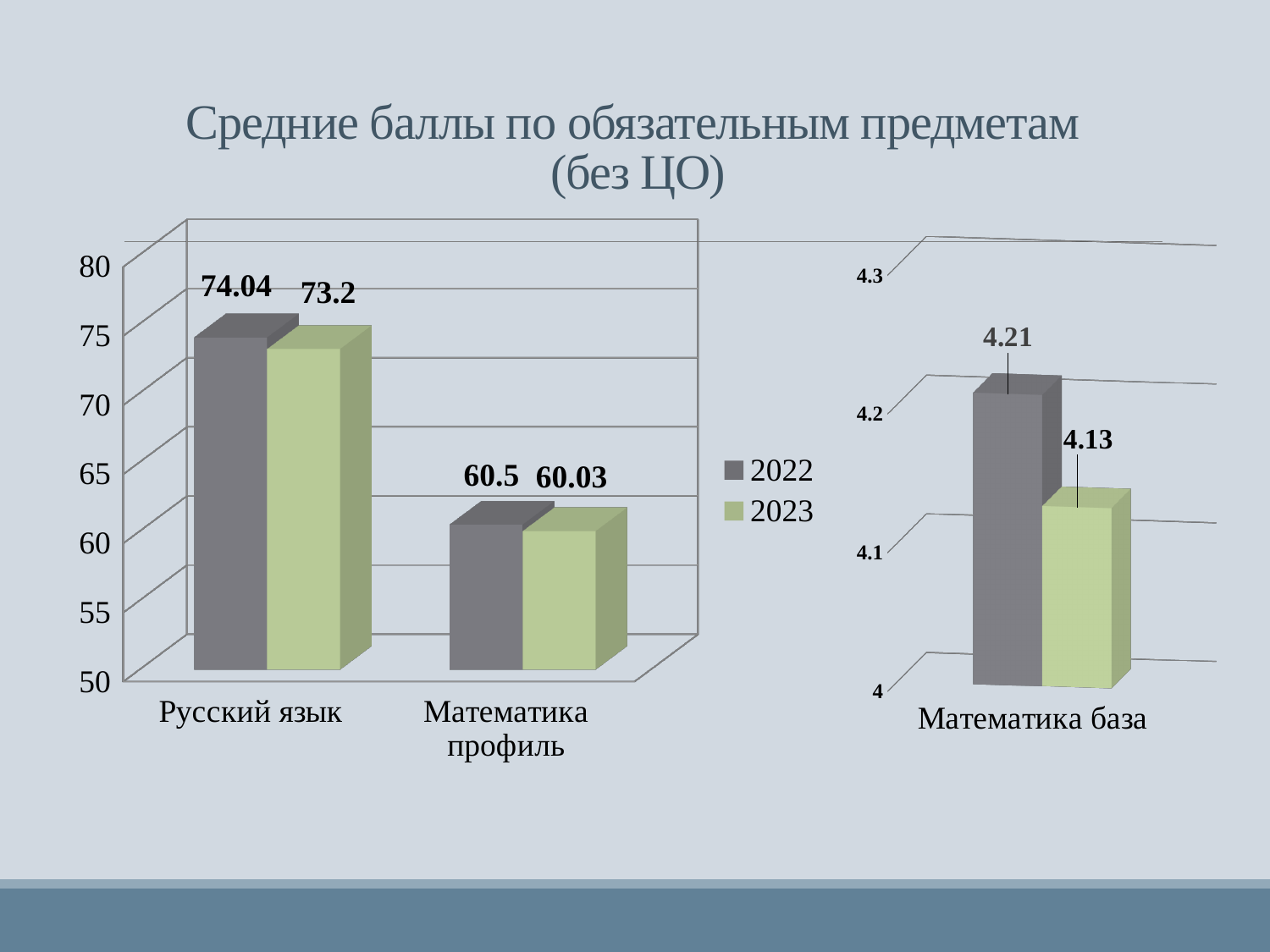
In the left chart, what is the value for Русский язык in 2022? 74.04 In the left chart, what is the value for Математика профиль in 2023? 60.03 How many categories are shown on the x axis of the left chart? 2 What kind of chart is the right chart? bar chart In the right chart, what is the value for Математика база in 2022? 4.21 How many series does the legend list? 2 In the left chart, which category has the lowest value in 2022? Математика профиль In the left chart, which category has the highest value in 2023? Русский язык In the right chart, what is the value for Математика база in 2023? 4.13 In the left chart, which is larger for Математика профиль: the 2022 value or the 2023 value? 2022 In the right chart, what is the difference between the 2022 and 2023 values for Математика база? 0.08 In the left chart, what is the difference between the 2022 and 2023 values for Русский язык? 0.84